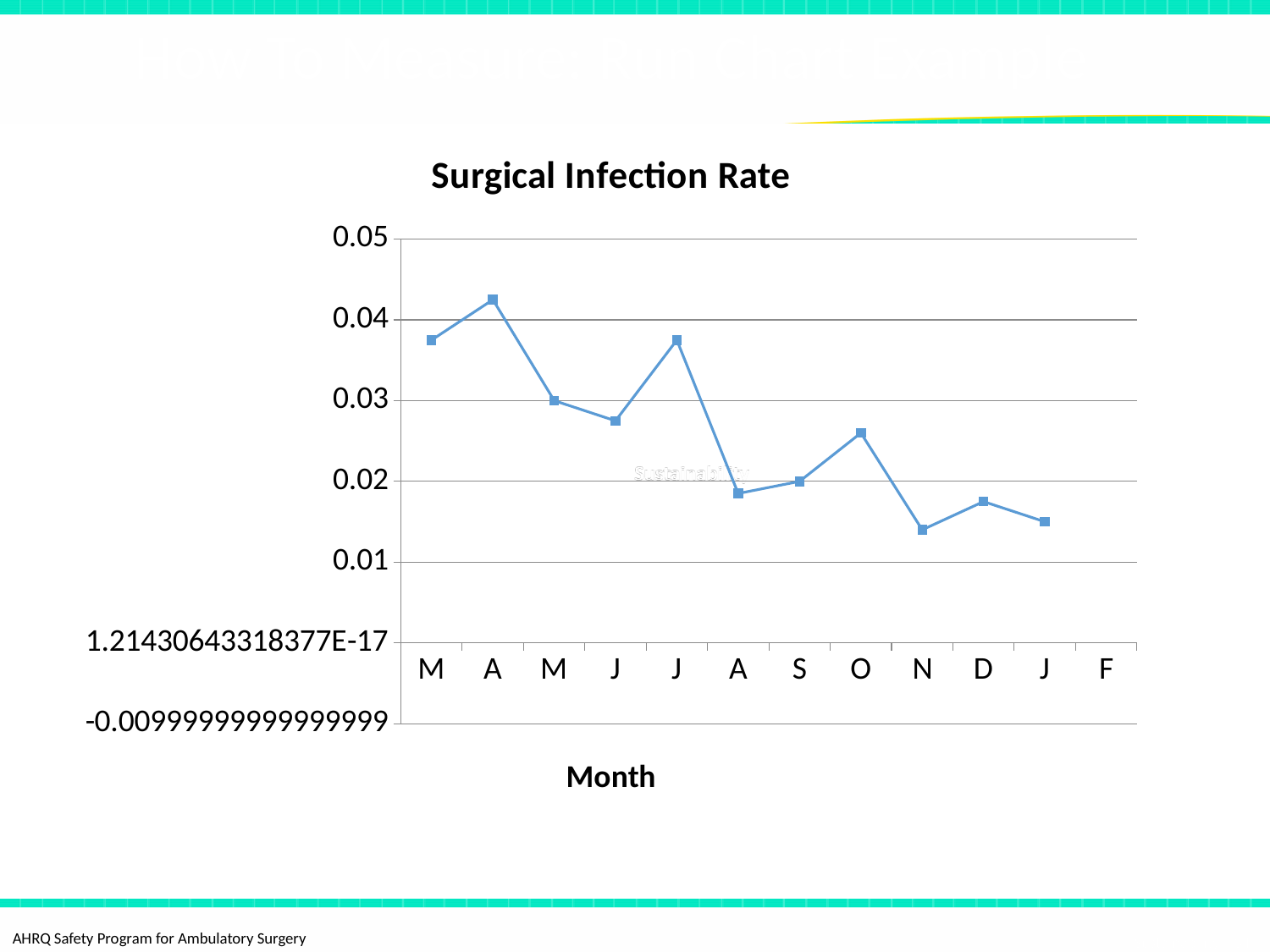
Is the value for the first month (M) greater or less than 0.03? greater What is the title of the chart? Surgical Infection Rate Is the value for the month N greater or less than 0.02? less Is the value for the sixth month (A) greater or less than 0.02? less Which month has the highest surgical infection rate? A (the second month) How many month labels are shown on the x axis? 12 Overall, do the surgical infection rate values rise or fall from the first month to the last plotted month? fall Which is larger, the value for the second month (A) or the value for the month N? A What is the x-axis title of the chart? Month What kind of chart is shown on the slide? line chart